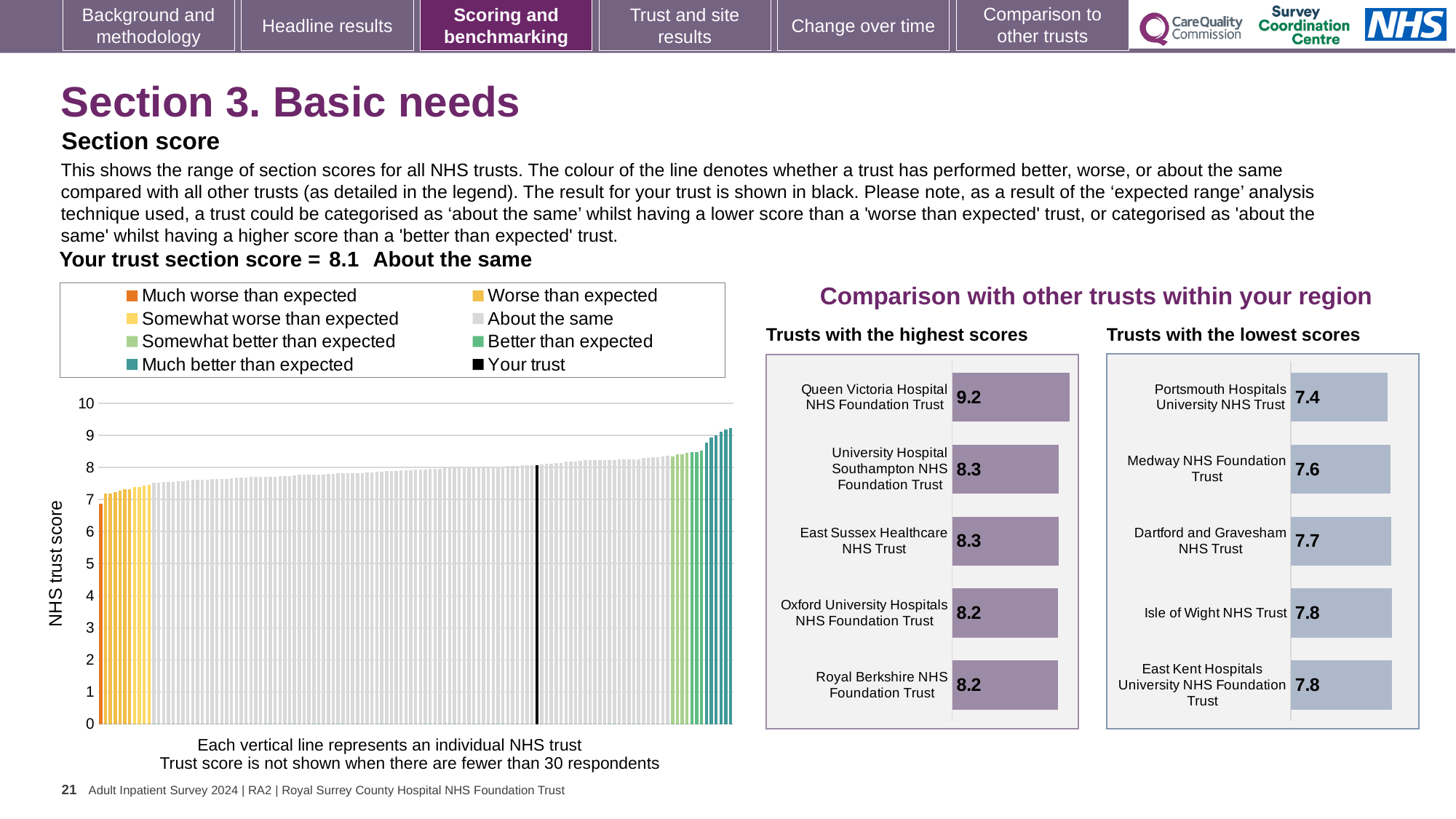
In the main 'NHS trust score' chart, is the value of the tallest bar on the right greater or less than 9? greater In the 'Trusts with the lowest scores' chart, what is the score for Portsmouth Hospitals University NHS Trust? 7.4 How many trusts are shown in the 'Trusts with the highest scores' chart? 5 In the 'Trusts with the highest scores' chart, what is the score for Queen Victoria Hospital NHS Foundation Trust? 9.2 What kind of chart is the main 'NHS trust score' chart on the left? bar chart In the 'Trusts with the lowest scores' chart, which trust has the lowest score? Portsmouth Hospitals University NHS Trust In the 'Trusts with the lowest scores' chart, which has the higher score: Medway NHS Foundation Trust or Dartford and Gravesham NHS Trust? Dartford and Gravesham NHS Trust In the main 'NHS trust score' chart, do the trust scores rise or fall from left to right? rise In the 'Trusts with the lowest scores' chart, how much higher is the score for Isle of Wight NHS Trust than for Portsmouth Hospitals University NHS Trust? 0.4 How many entries does the legend of the main NHS trust score chart list? 8 In the 'Trusts with the highest scores' chart, which trust has the highest score? Queen Victoria Hospital NHS Foundation Trust In the 'Trusts with the highest scores' chart, what is the difference between the scores of Queen Victoria Hospital NHS Foundation Trust and Royal Berkshire NHS Foundation Trust? 1.0